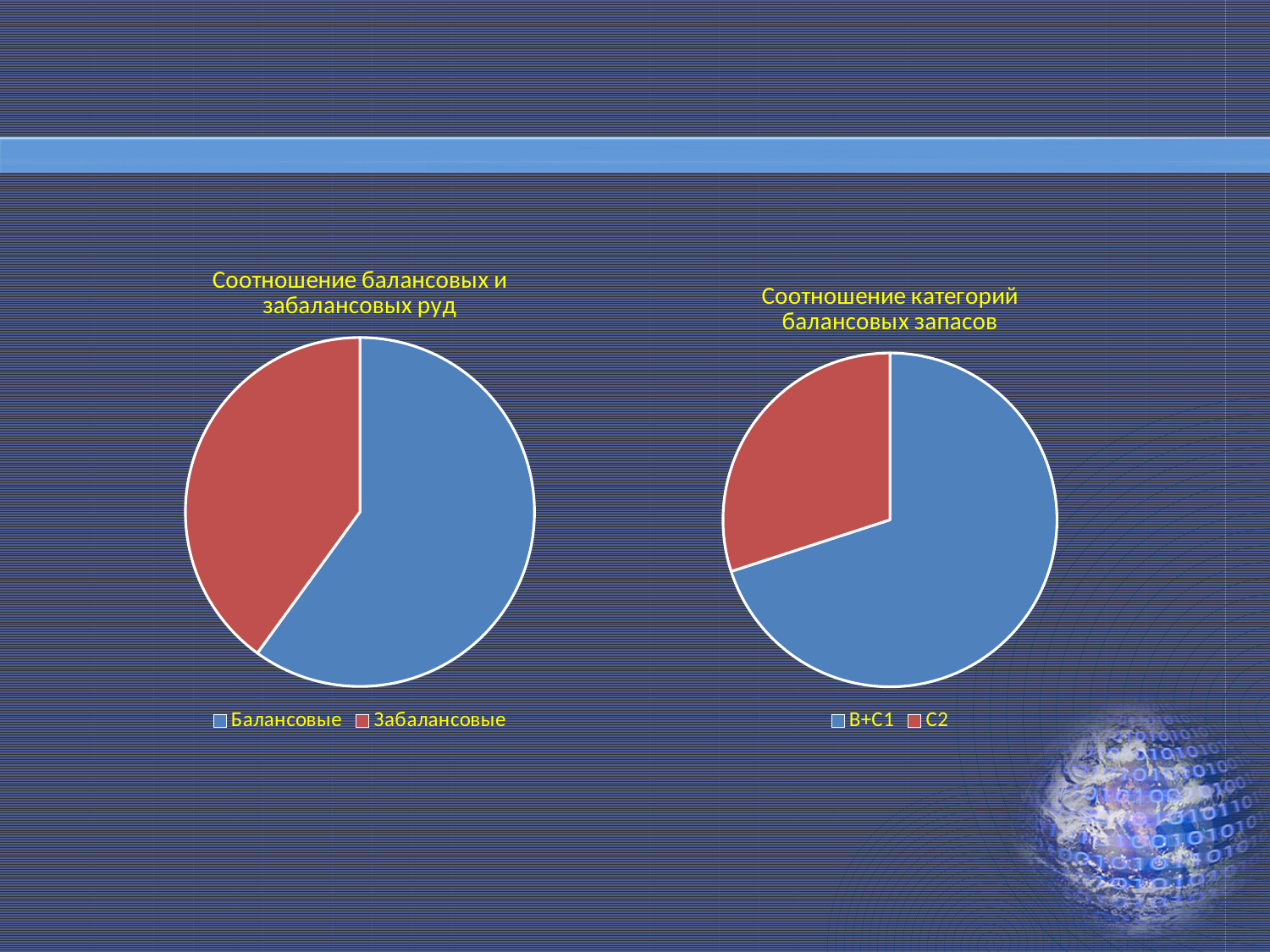
What kind of chart is the left chart titled "Соотношение балансовых и забалансовых руд"? pie chart In the right chart "Соотношение категорий балансовых запасов", which category has the smallest slice? C2 In the right chart "Соотношение категорий балансовых запасов", what colour is the C2 slice? red In the right chart "Соотношение категорий балансовых запасов", which category has the largest slice? B+C1 In the left chart "Соотношение балансовых и забалансовых руд", how many slices does the pie have? 2 What kind of chart is the right chart titled "Соотношение категорий балансовых запасов"? pie chart In the left chart "Соотношение балансовых и забалансовых руд", which category has the smallest slice? Забалансовые In the right chart "Соотношение категорий балансовых запасов", which slice is larger, B+C1 or C2? B+C1 In the left chart "Соотношение балансовых и забалансовых руд", which slice is larger, Балансовые or Забалансовые? Балансовые In the right chart "Соотношение категорий балансовых запасов", how many categories does the legend list? 2 In the left chart "Соотношение балансовых и забалансовых руд", which category has the largest slice? Балансовые What is the title of the left chart on the slide? Соотношение балансовых и забалансовых руд